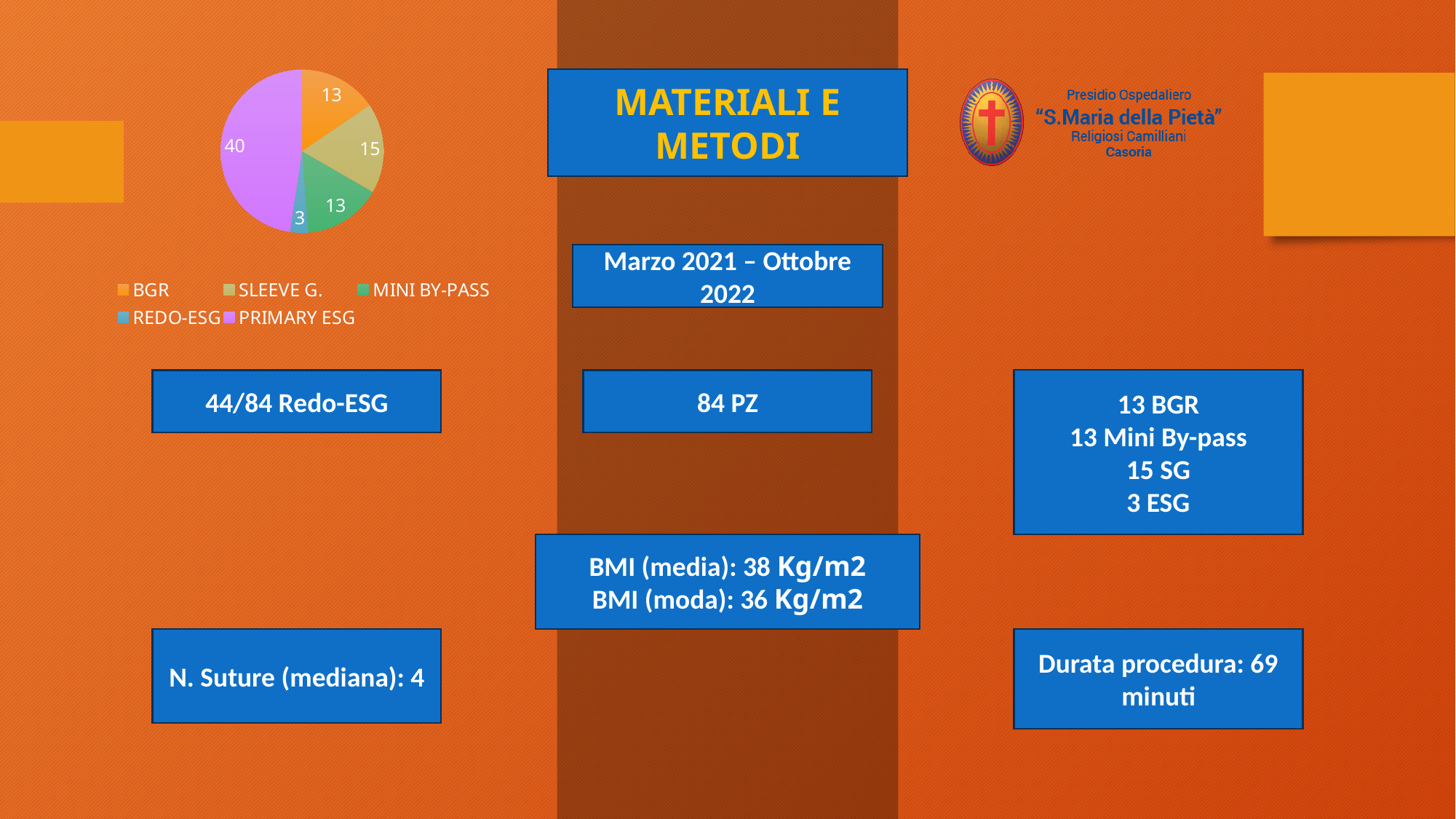
Which category has the largest slice in the pie chart? PRIMARY ESG Which category has the smallest slice in the pie chart? REDO-ESG What is the value for REDO-ESG in the pie chart? 3 What is the value for BGR in the pie chart? 13 What is the total of all the values shown in the pie chart? 84 Which is larger in the pie chart, SLEEVE G. or BGR? SLEEVE G. What is the difference between the values for PRIMARY ESG and SLEEVE G. in the pie chart? 25 How many categories does the pie chart show? 5 What is the value for SLEEVE G. in the pie chart? 15 What type of chart is shown on the slide? pie chart What is the difference between the values for MINI BY-PASS and REDO-ESG in the pie chart? 10 What is the value for PRIMARY ESG in the pie chart? 40